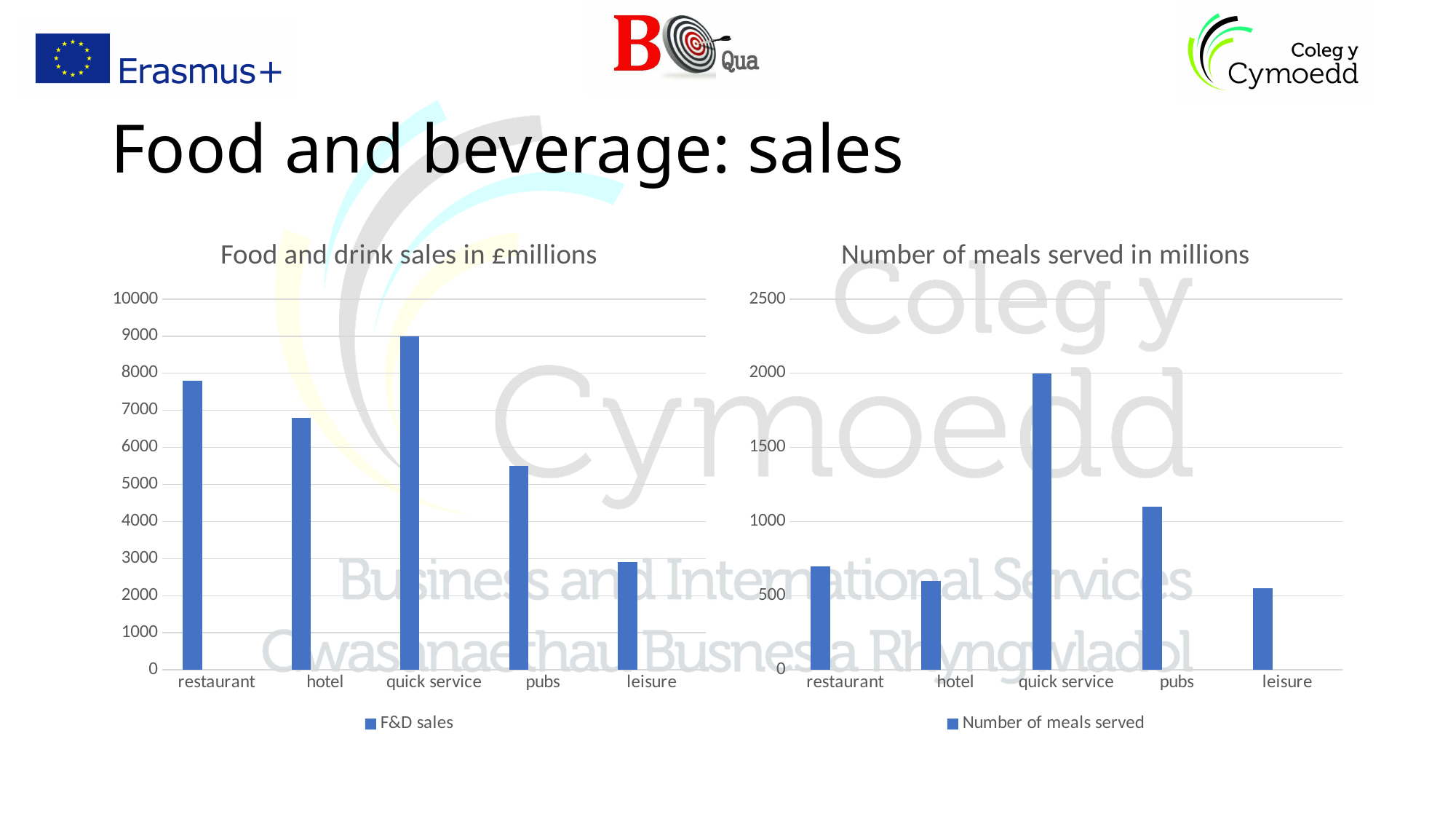
In the 'Number of meals served in millions' chart, which category has the highest value? quick service In the 'Food and drink sales in £millions' chart, which category has the highest value? quick service In the 'Number of meals served in millions' chart, what is the value for quick service? 2000 In the 'Food and drink sales in £millions' chart, is the value for hotel greater or less than 7000? less In the 'Food and drink sales in £millions' chart, which category has the lowest value? leisure How many categories are shown in the 'Number of meals served in millions' chart? 5 What type of chart is the 'Food and drink sales in £millions' chart? bar chart What is the legend entry in the 'Number of meals served in millions' chart? Number of meals served In the 'Food and drink sales in £millions' chart, is the value for restaurant greater or less than 7000? greater In the 'Food and drink sales in £millions' chart, what is the value for quick service? 9000 In the 'Food and drink sales in £millions' chart, which is larger, restaurant or hotel? restaurant In the 'Number of meals served in millions' chart, is the value for pubs greater or less than 1000? greater